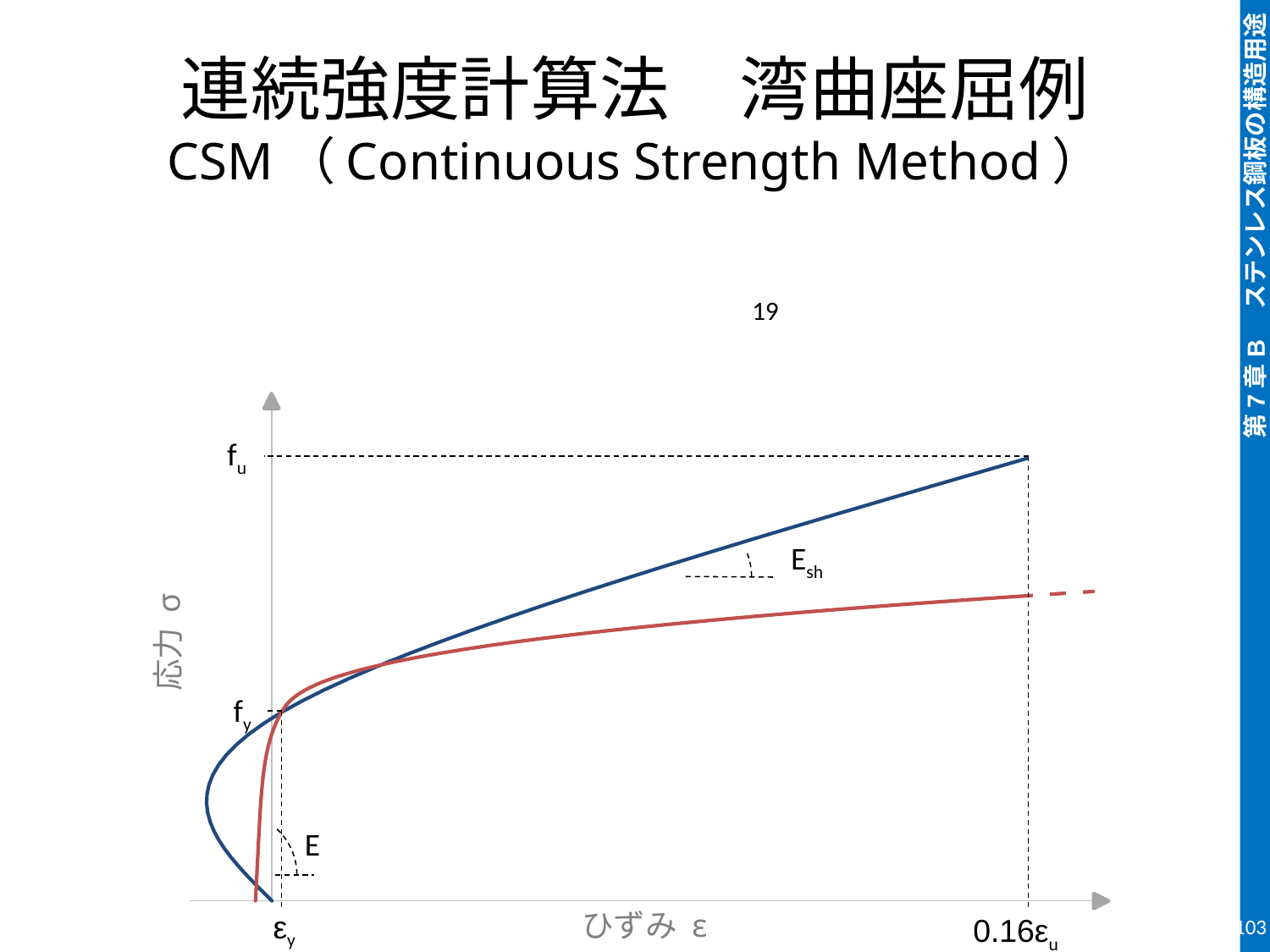
At the strain 0.16ε_u, which curve has the higher stress, the blue line or the red curve? the blue line What is the label of the horizontal axis of the chart? ひずみ ε How many strain values are labelled on the horizontal axis? 2 How many curves are plotted on the chart? 2 What stress level does the blue line reach at the strain 0.16ε_u? f_u What stress level is marked on the vertical axis at the strain ε_y? f_y What is the label of the vertical axis of the chart? 応力 σ Which slope label is attached to the initial steep part of the curve near the origin? E Does the blue line rise or fall as strain increases from ε_y to 0.16ε_u? rise Which slope label is attached to the blue line between ε_y and 0.16ε_u? E_sh What kind of chart is shown on the slide? line chart